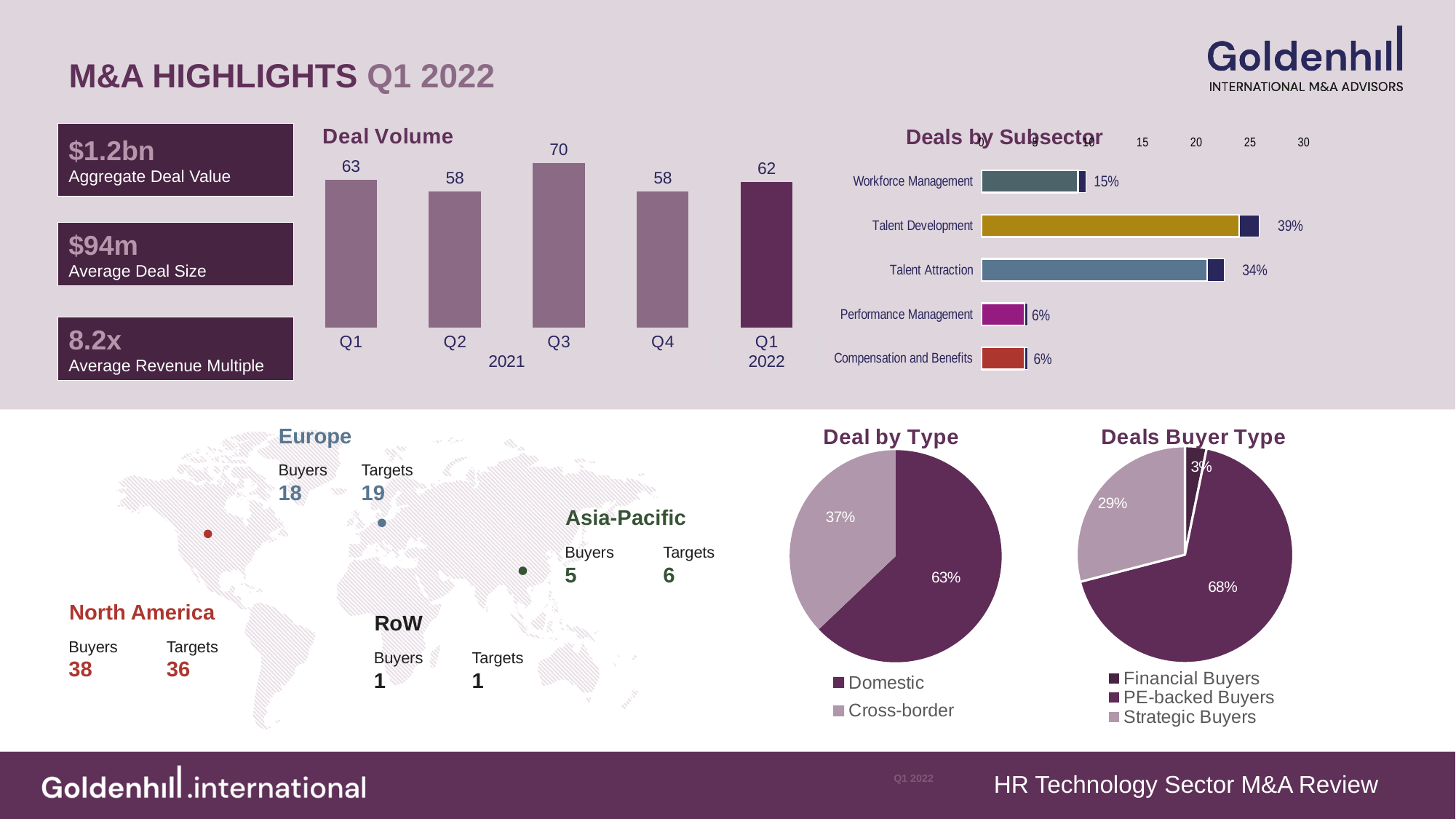
In the Deals by Subsector chart, which subsector has the highest share of deals? Talent Development In the Deal by Type pie chart, what share of deals is Cross-border? 37% In the Deal Volume chart, how many quarters are plotted? 5 What kind of chart is the Deal Volume chart? bar chart In the Deals by Subsector chart, how many subsectors are listed? 5 In the Deal Volume chart, which quarter has the highest deal volume? Q3 2021 In the Deal Volume chart, what is the deal volume for Q3 2021? 70 In the Deals Buyer Type pie chart, which buyer type has the largest share? PE-backed Buyers In the Deals by Subsector chart, what percentage is shown for Talent Attraction? 34% In the Deal Volume chart, is the deal volume for Q1 2021 larger or smaller than for Q2 2021? larger In the Deals Buyer Type pie chart, how many buyer types does the legend list? 3 In the Deal Volume chart, what is the difference between the deal volume in Q3 2021 and Q1 2022? 8